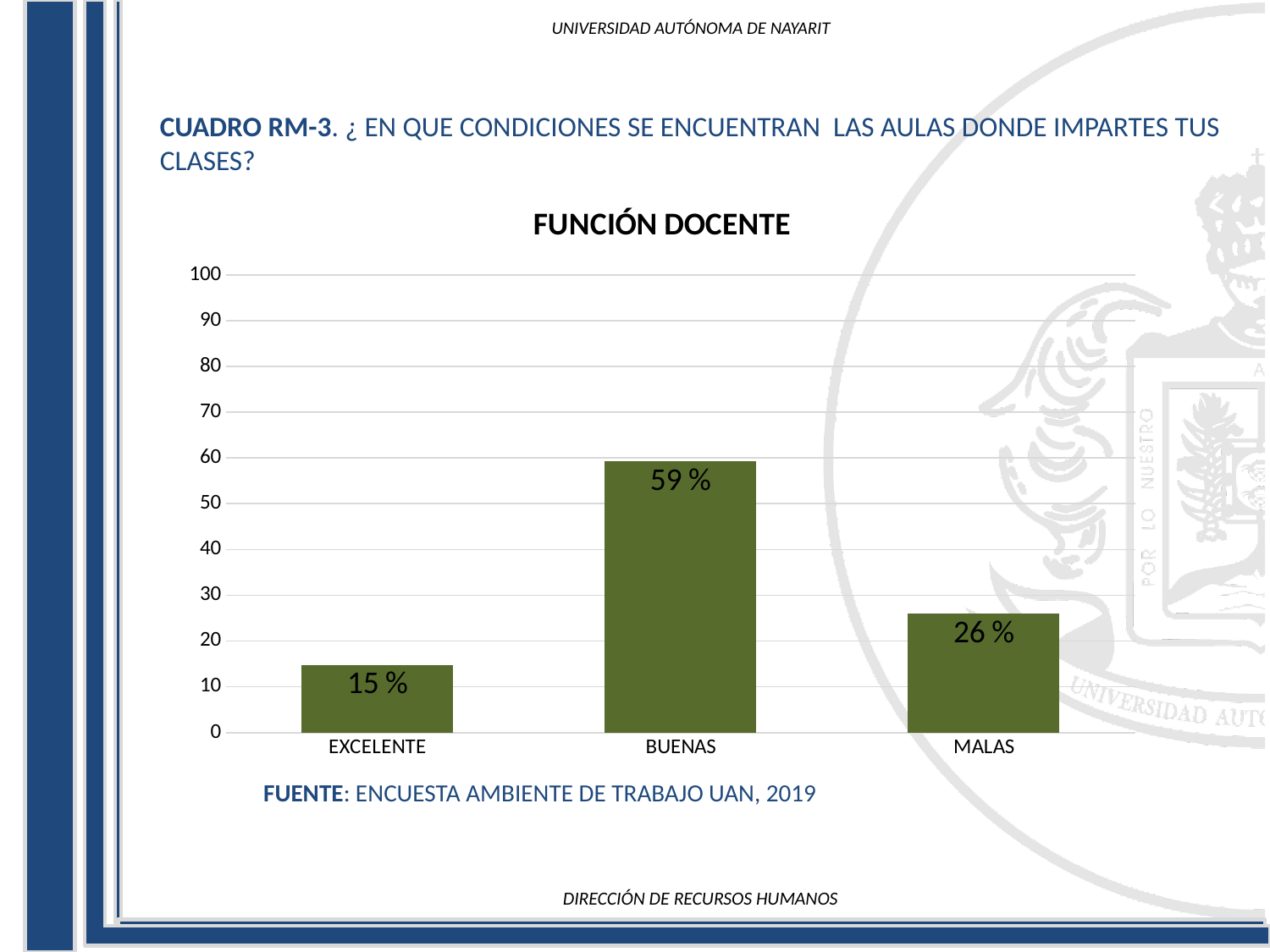
What is the title of the chart? FUNCIÓN DOCENTE What kind of chart is shown on the slide? bar chart What is the value for BUENAS? 59 % What is the difference between the values for BUENAS and MALAS? 33 % What is the value for EXCELENTE? 15 % How many categories are shown on the x axis? 3 What is the value for MALAS? 26 % Is the value for BUENAS greater or less than 50? greater Which category has the highest value? BUENAS Which category has the lowest value? EXCELENTE Which is larger, the value for MALAS or the value for EXCELENTE? MALAS What is the difference between the values for MALAS and EXCELENTE? 11 %